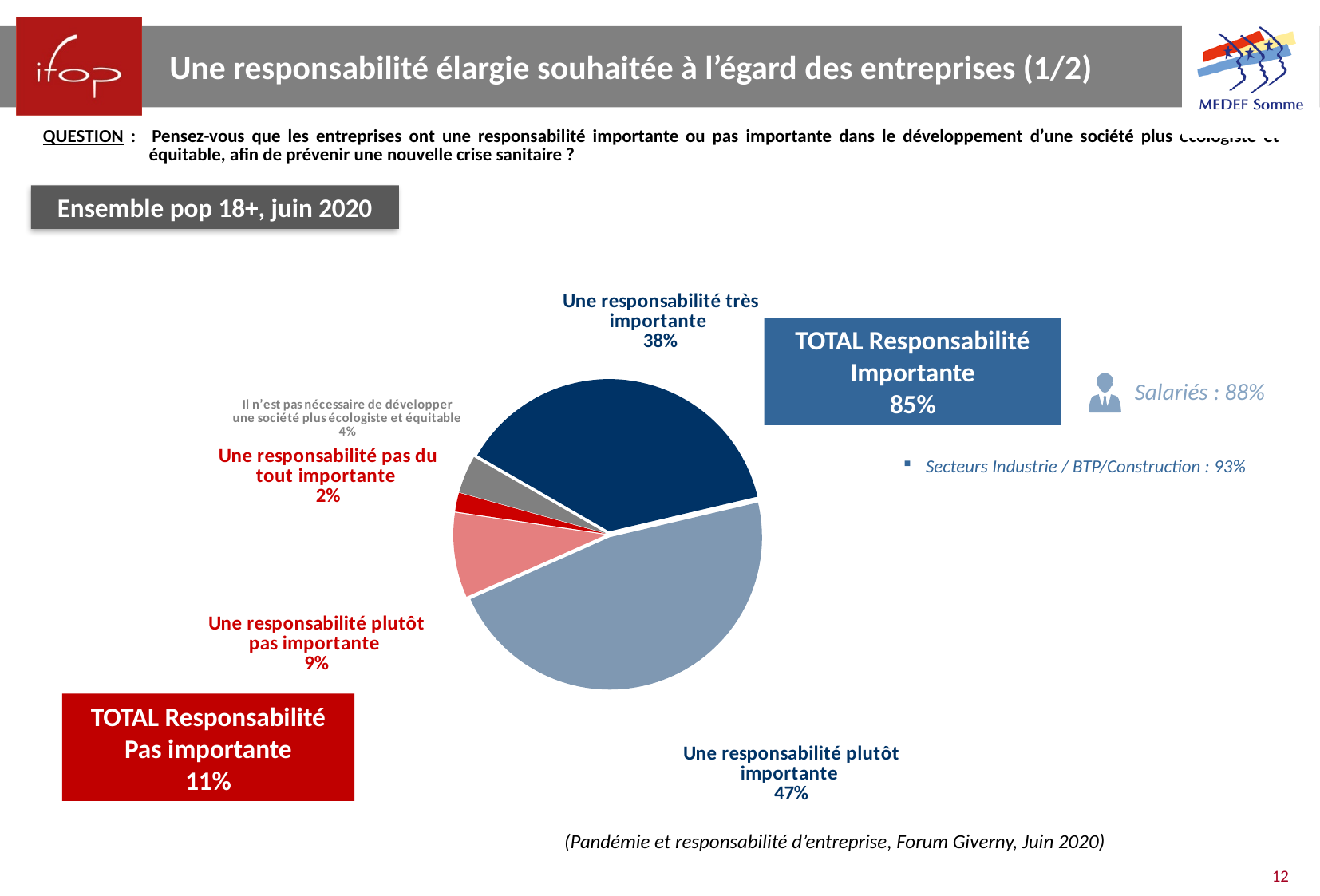
What share of respondents answered "Une responsabilité plutôt pas importante"? 9% Which response has the smallest slice of the pie? Une responsabilité pas du tout importante What share of respondents answered "Une responsabilité plutôt importante"? 47% What is the value shown in the box labelled "TOTAL Responsabilité Importante"? 85% Which is larger: the share for "Une responsabilité plutôt pas importante" or for "Il n'est pas nécessaire de développer une société plus écologiste et équitable"? Une responsabilité plutôt pas importante What share of respondents answered "Une responsabilité très importante"? 38% What is the difference between the shares for "Une responsabilité plutôt importante" and "Une responsabilité très importante"? 9 points What share of respondents answered "Une responsabilité pas du tout importante"? 2% Which response has the largest slice of the pie? Une responsabilité plutôt importante What kind of chart is shown on the slide? pie chart What share of respondents answered "Il n'est pas nécessaire de développer une société plus écologiste et équitable"? 4% How many slices does the pie chart have? 5